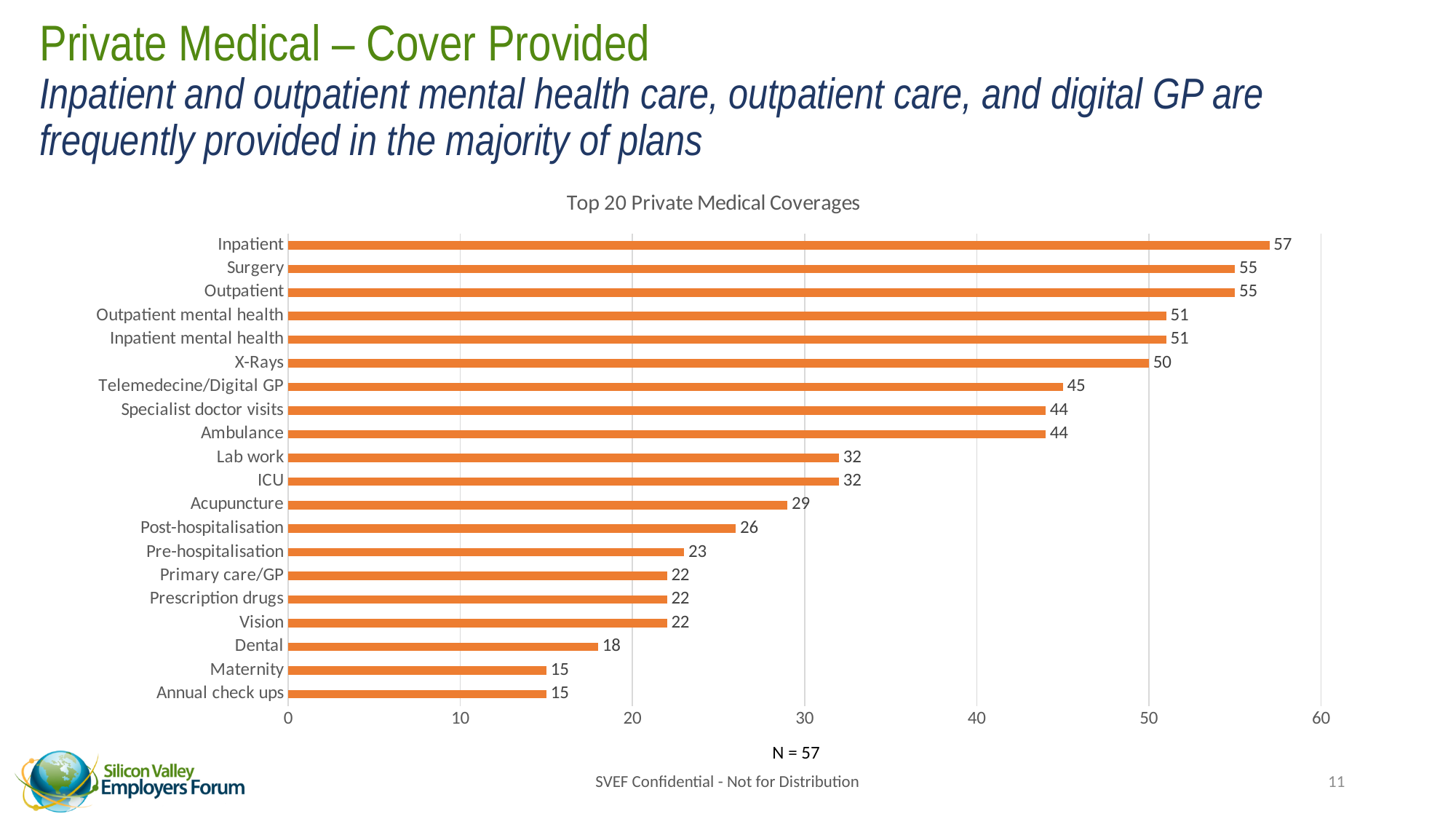
What is the value for Acupuncture? 29 What is the value for Telemedecine/Digital GP? 45 What is the title of the chart? Top 20 Private Medical Coverages What is the difference between the values for Inpatient and X-Rays? 7 What is the value for Dental? 18 Is the value for Pre-hospitalisation greater or less than 20? greater What kind of chart is shown on the slide? Bar chart What is the value for Inpatient? 57 What is the difference between the values for Lab work and Maternity? 17 How many categories are shown in the chart? 20 Which is larger, the value for Ambulance or the value for Post-hospitalisation? Ambulance Which category has the highest value? Inpatient